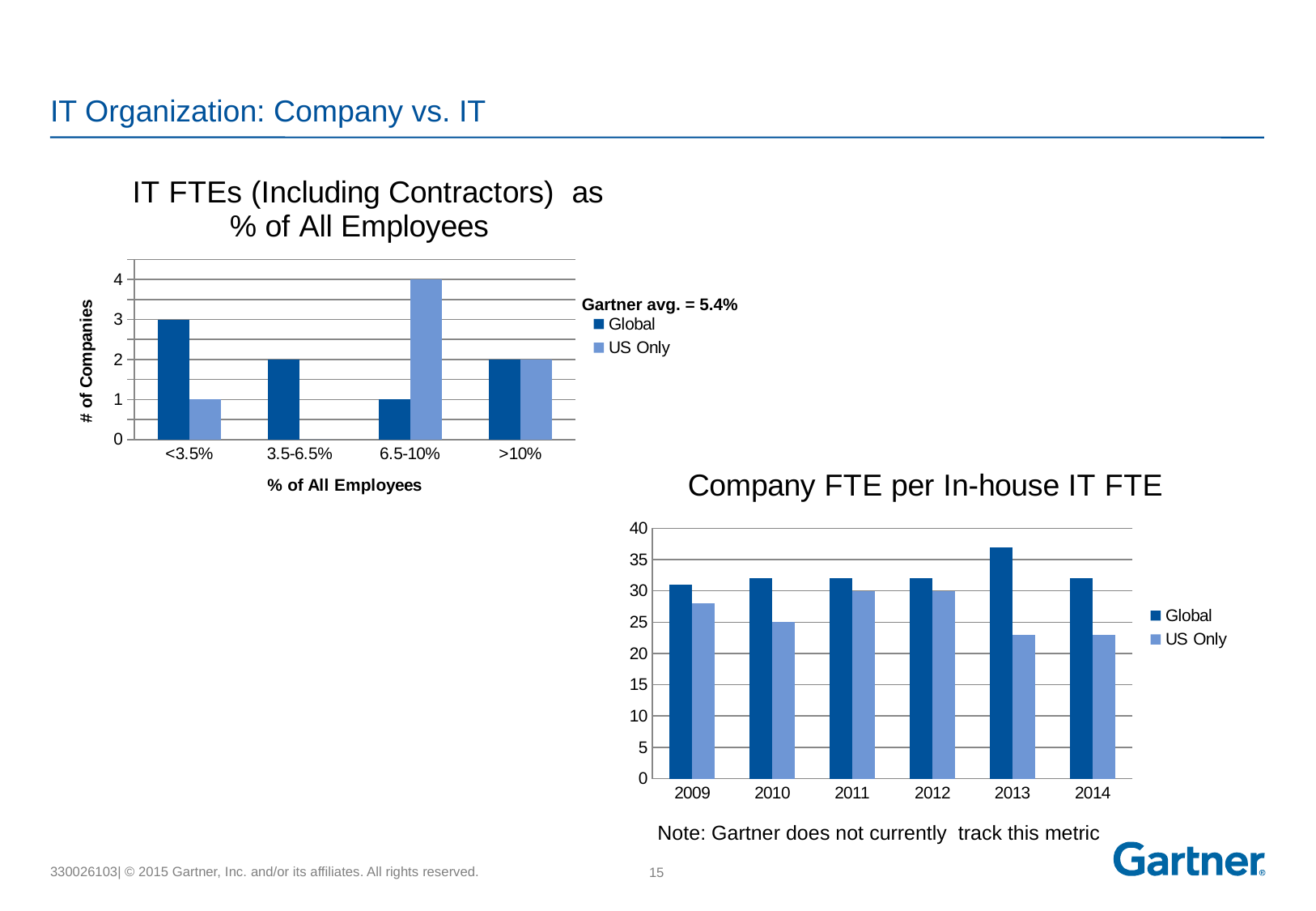
In the chart titled 'IT FTEs (Including Contractors) as % of All Employees', what is the Global value for the <3.5% category? 3 In the chart titled 'IT FTEs (Including Contractors) as % of All Employees', what is the US Only value for the 6.5-10% category? 4 What kind of chart is 'Company FTE per In-house IT FTE'? bar chart In the chart titled 'IT FTEs (Including Contractors) as % of All Employees', which category has the highest US Only value? 6.5-10% In the chart titled 'Company FTE per In-house IT FTE', which year has the highest Global value? 2013 In the chart titled 'Company FTE per In-house IT FTE', what is the US Only value for 2010? 25 In the chart titled 'IT FTEs (Including Contractors) as % of All Employees', which category has the lowest Global value? 6.5-10% In the chart titled 'Company FTE per In-house IT FTE', is the Global value for 2012 larger or smaller than the US Only value for 2012? larger In the chart titled 'IT FTEs (Including Contractors) as % of All Employees', how many categories are shown on the x axis? 4 In the chart titled 'IT FTEs (Including Contractors) as % of All Employees', what Gartner average is noted next to the legend? 5.4% In the chart titled 'IT FTEs (Including Contractors) as % of All Employees', what is the difference between the Global and US Only values for the <3.5% category? 2 In the chart titled 'Company FTE per In-house IT FTE', is the Global value for 2013 greater or less than 35? greater